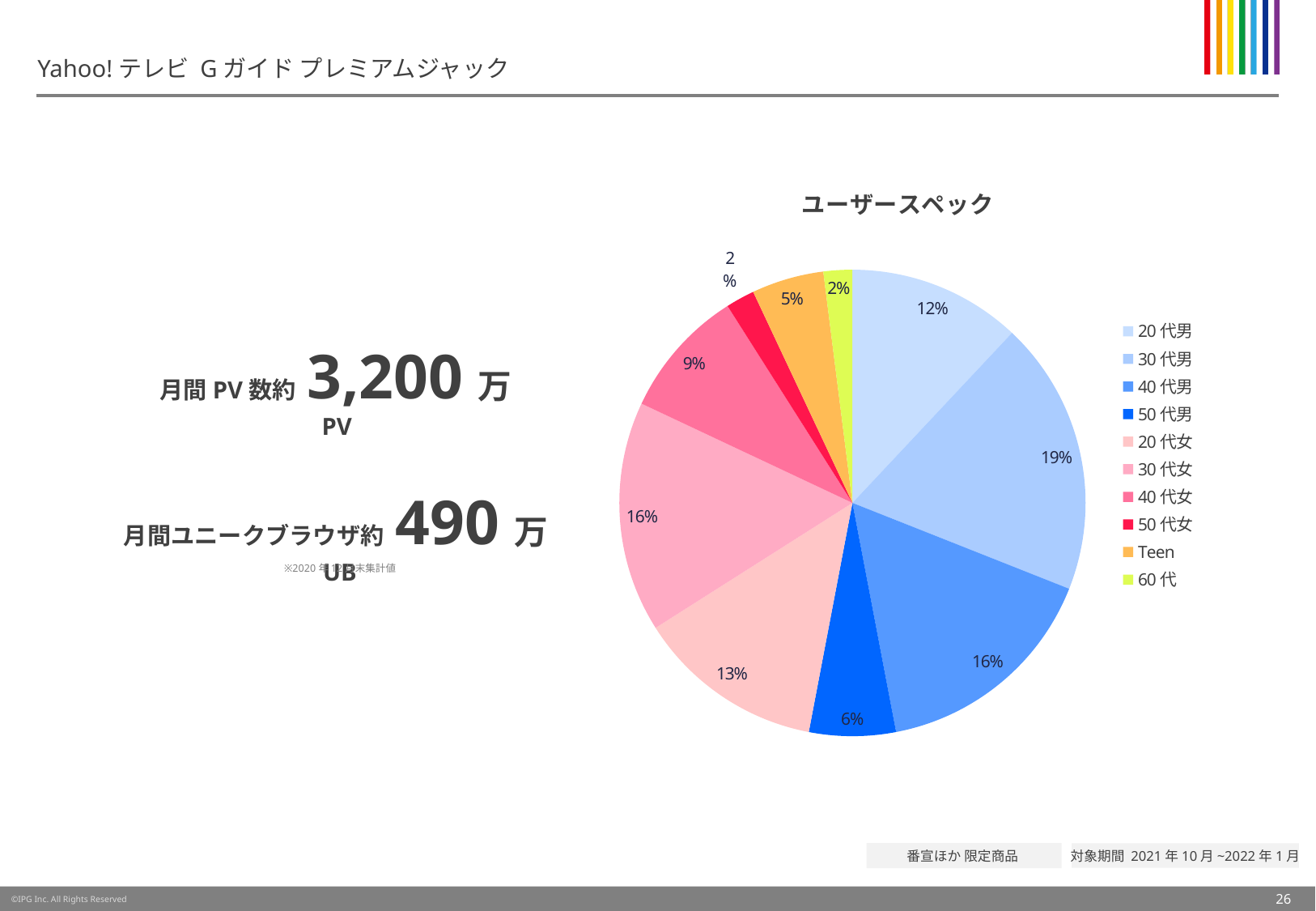
What is the share for Teen in the ユーザースペック pie chart? 5% What kind of chart is shown under the title ユーザースペック? pie chart What is the difference between the shares of 30代男 and 50代男 in the ユーザースペック pie chart? 13% What is the share for 30代男 in the ユーザースペック pie chart? 19% How many entries does the legend of the ユーザースペック pie chart list? 10 Which category has the largest slice in the ユーザースペック pie chart? 30代男 What is the share for 20代男 in the ユーザースペック pie chart? 12% What is the title of the pie chart on the slide? ユーザースペック What is the share for 50代男 in the ユーザースペック pie chart? 6% What is the share for 40代女 in the ユーザースペック pie chart? 9% Which is larger in the ユーザースペック pie chart, 20代女 or 20代男? 20代女 How many slices does the ユーザースペック pie chart have? 10